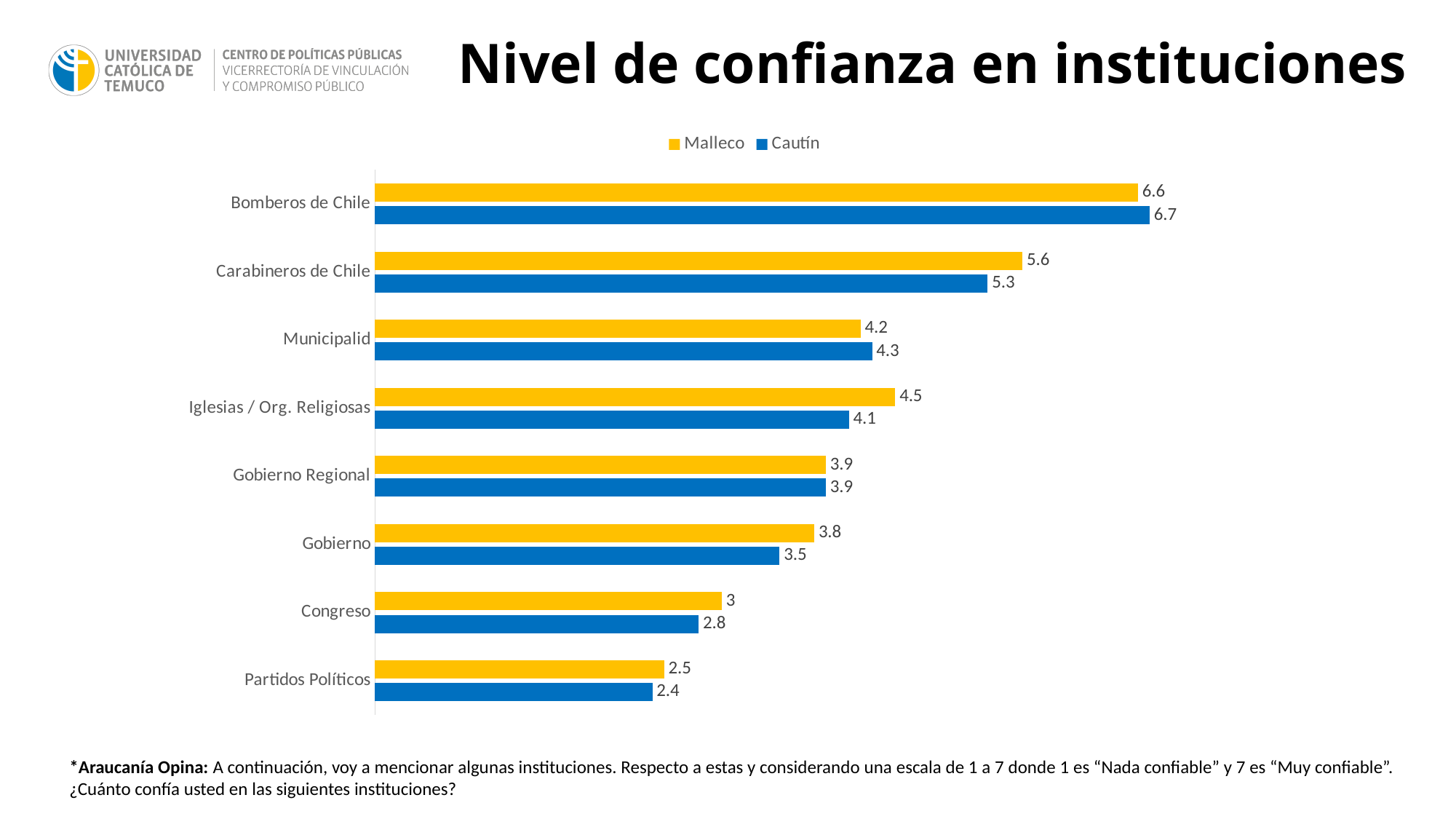
What is the Malleco value for Carabineros de Chile? 5.6 How many series does the legend list? 2 What is the difference between the Malleco values for Bomberos de Chile and Congreso? 3.6 Which institution has the highest Cautín value? Bomberos de Chile What kind of chart is shown on the slide? Bar chart What is the difference between the Malleco and Cautín values for Gobierno? 0.3 What is the Cautín value for Partidos Políticos? 2.4 Which institution has the lowest Malleco value? Partidos Políticos Which is larger for Carabineros de Chile, the Malleco value or the Cautín value? Malleco How many institutions are shown on the chart? 8 Which colour represents the Cautín series? Blue What is the Cautín value for Iglesias / Org. Religiosas? 4.1